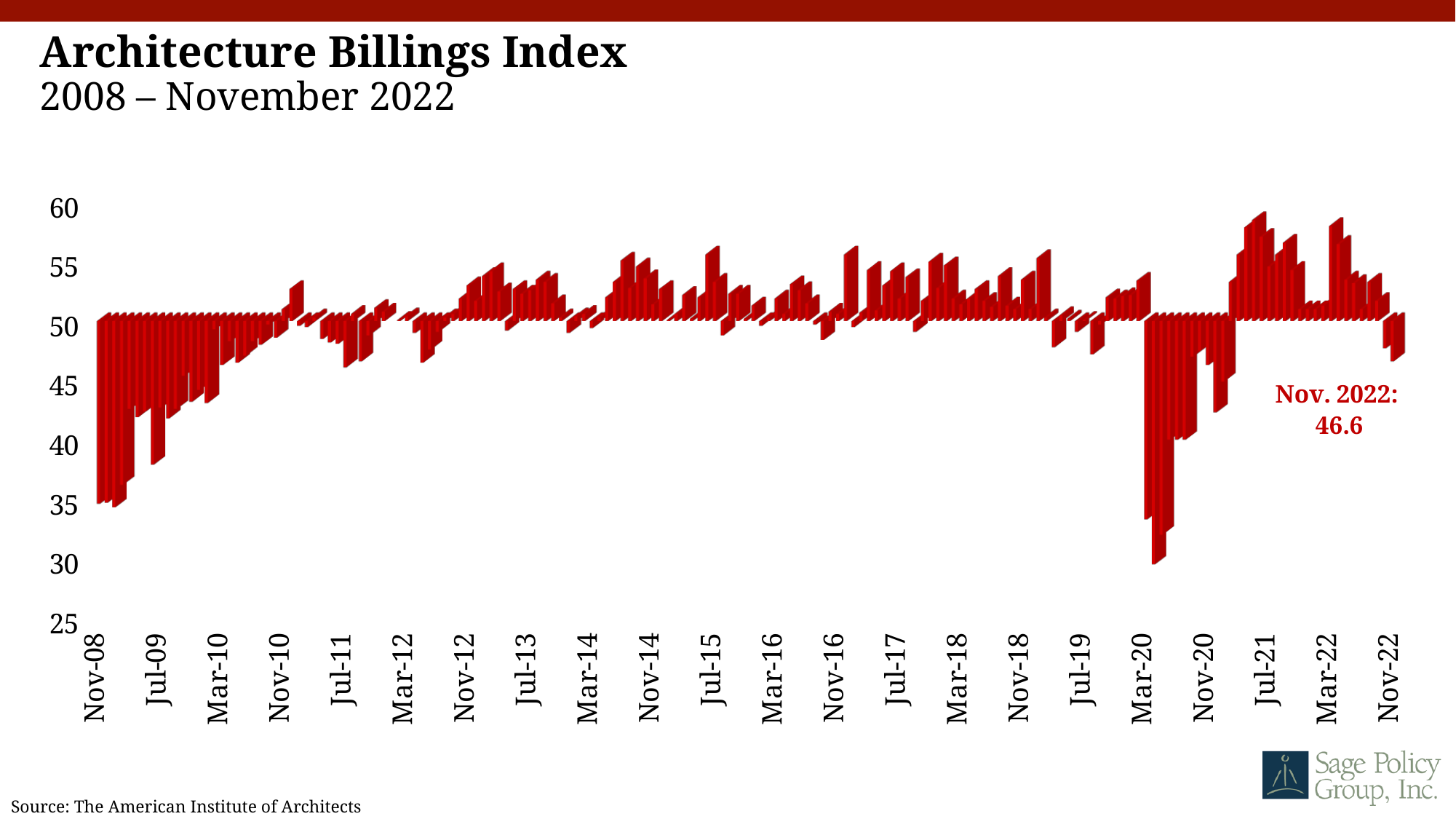
What is the value of the Architecture Billings Index for November 2022? 46.6 Is the value for Nov-22 greater or less than 50? less Do the values generally rise or fall from Nov-08 to Nov-10? rise Around which x-axis label does the lowest bar on the chart occur? Mar-20 Is the value for Mar-20 greater or less than 40? less Which is larger, the value for Nov-08 or the value for Jul-21? Jul-21 Is the value for Nov-08 greater or less than 40? less What kind of chart is shown on the slide? bar chart What is the title of the chart? Architecture Billings Index What is the source of the data shown in the chart? The American Institute of Architects Which is larger, the value for Mar-20 or the value for Nov-22? Nov-22